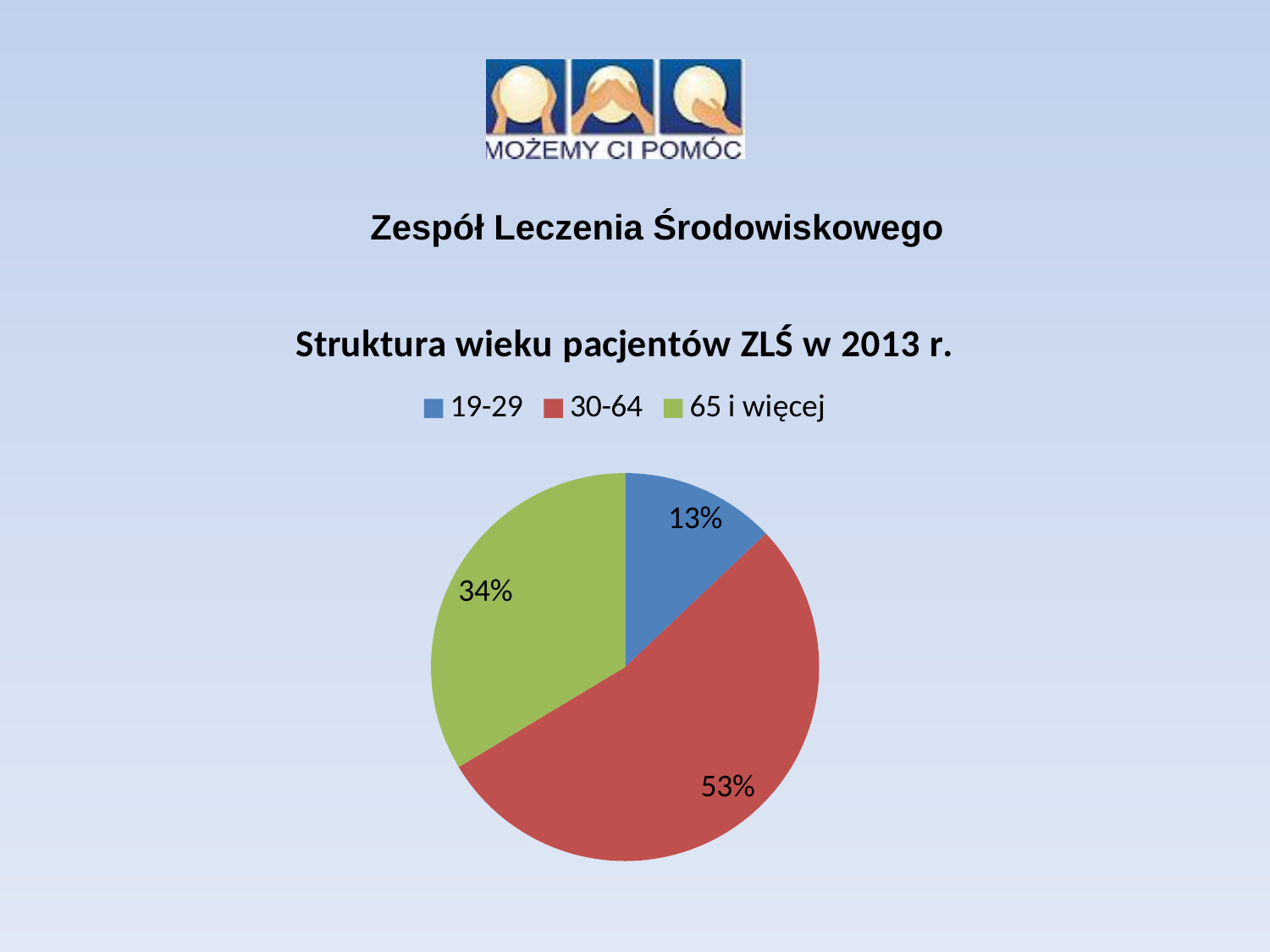
What is the difference in percentage points between the 30-64 and 19-29 shares? 40 Which age group has the smallest share of the pie? 19-29 What share of the pie does the 19-29 age group have? 13% What is the difference in percentage points between the '65 i więcej' and 19-29 shares? 21 What is the title of the chart? Struktura wieku pacjentów ZLŚ w 2013 r. What kind of chart is shown on the slide? pie chart What share of the pie does the 30-64 age group have? 53% What share of the pie does the '65 i więcej' age group have? 34% Which is larger, the share for 30-64 or the share for '65 i więcej'? 30-64 How many entries does the legend list? 3 Which age group has the largest share of the pie? 30-64 How many slices does the pie chart have? 3